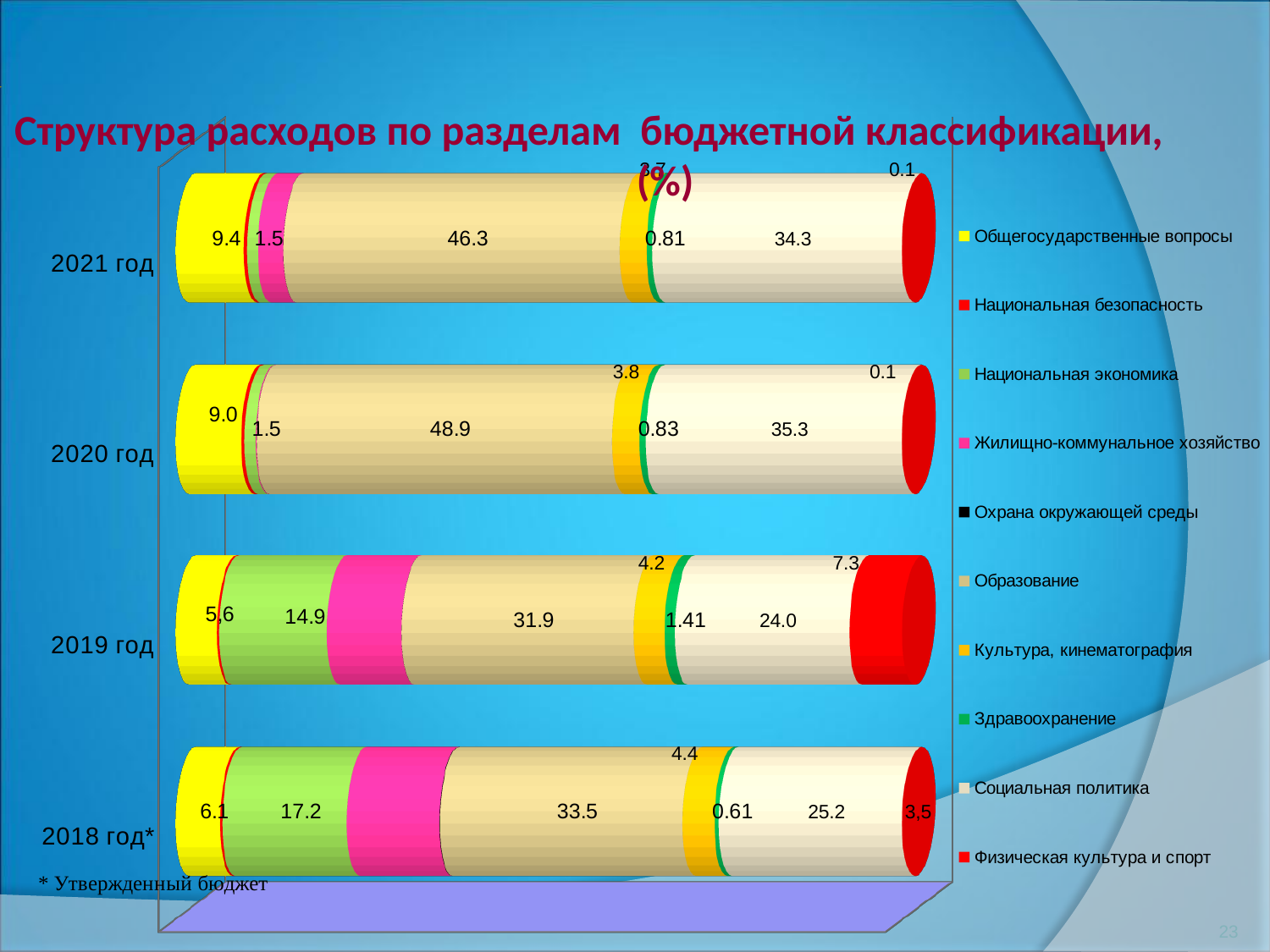
Which year has the larger value for Общегосударственные вопросы, 2021 год or 2018 год*? 2021 год How many years (categories) are plotted on the chart? 4 What is the value for Социальная политика in 2019 год? 24.0 What is the difference between the Социальная политика values for 2020 год and 2019 год? 11.3 How many series does the legend list? 10 What is the title of the chart? Структура расходов по разделам бюджетной классификации, (%) In which year is the value for Образование the highest? 2020 год What is the value for Физическая культура и спорт in 2019 год? 7.3 In which year is the value for Здравоохранение the lowest? 2018 год* What kind of chart is shown on the slide? bar chart What is the value for Образование in 2021 год? 46.3 What is the value for Национальная экономика in 2018 год*? 17.2